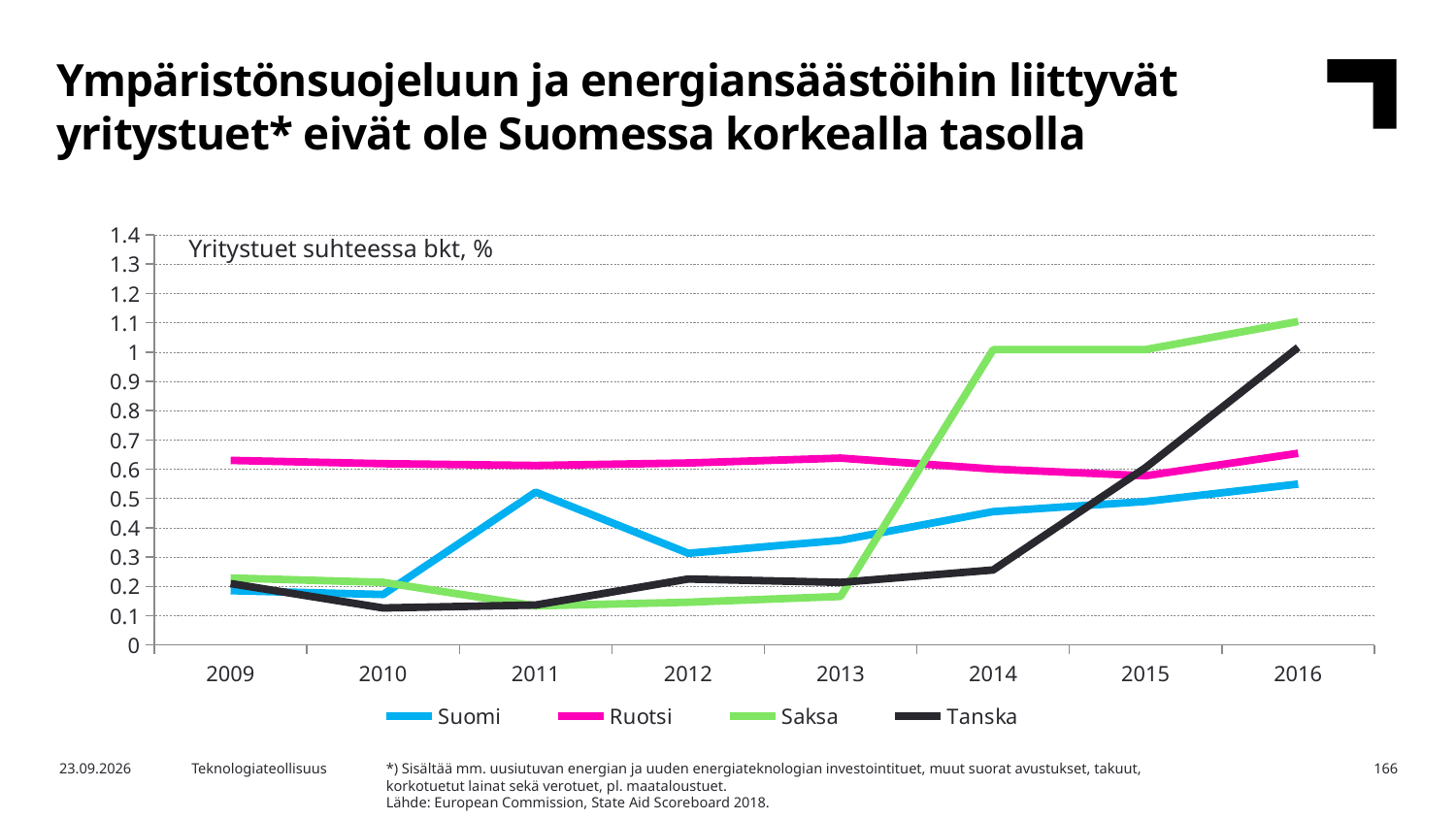
How many years are shown on the x axis? 8 Is the value for Ruotsi in 2009 greater or less than 0.5? greater Which country has the lowest value in 2010? Tanska Which country has the highest value in 2009? Ruotsi Which country has the highest value in 2016? Saksa Is the value for Saksa in 2016 greater or less than 1? greater What kind of chart is shown on the slide? line chart What is the title shown inside the chart area? Yritystuet suhteessa bkt, % In 2011, which is larger: the value for Suomi or the value for Tanska? Suomi Does the value for Tanska rise or fall from 2013 to 2016? rise How many series does the legend list? 4 Is the value for Suomi in 2016 greater or less than 0.6? less